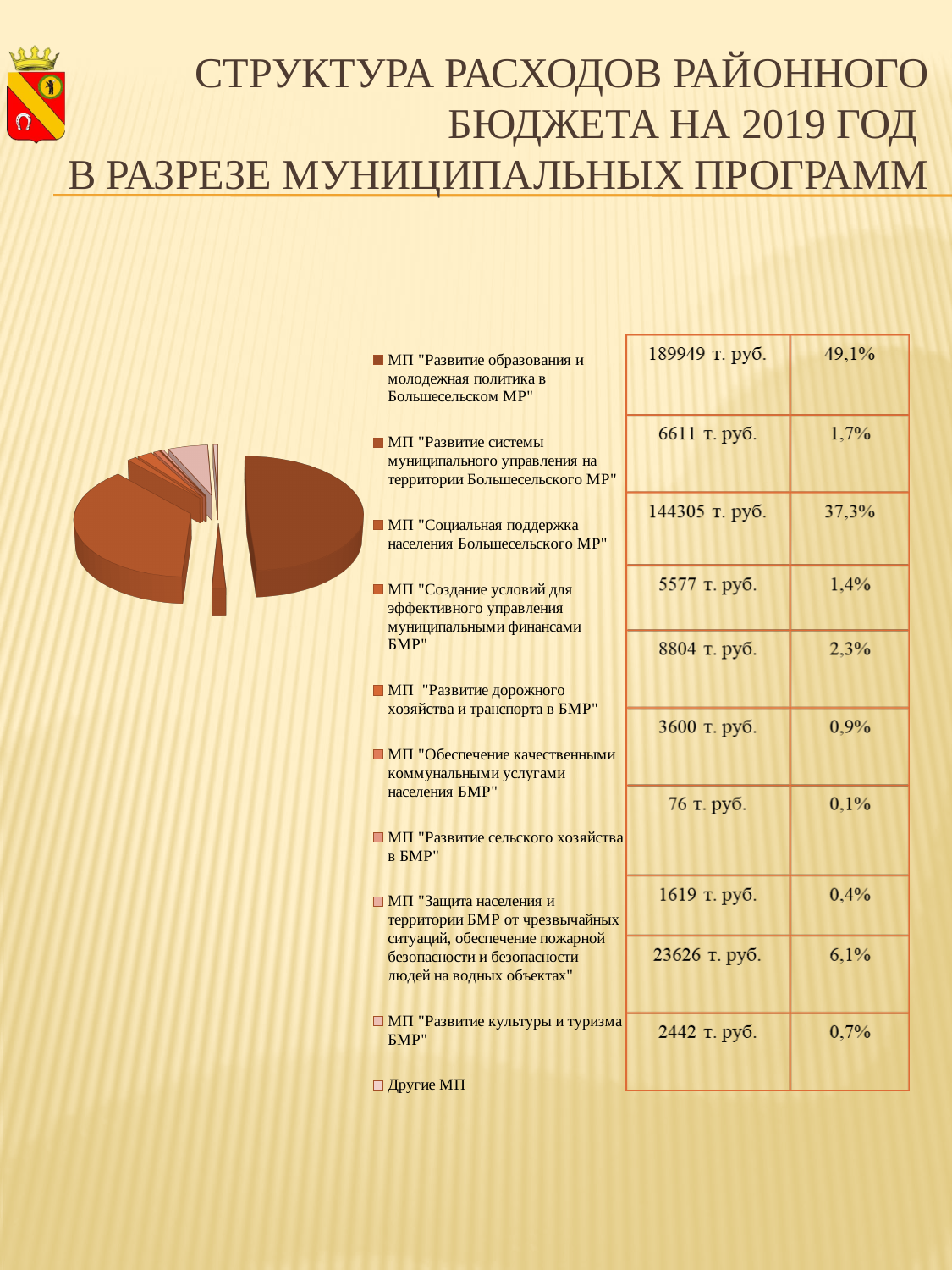
What kind of chart is shown on the slide? Pie chart What is the title of the slide containing the pie chart? СТРУКТУРА РАСХОДОВ РАЙОННОГО БЮДЖЕТА НА 2019 ГОД В РАЗРЕЗЕ МУНИЦИПАЛЬНЫХ ПРОГРАММ What share of the budget does МП "Социальная поддержка населения Большесельского МР" account for? 37,3% What is the amount shown for МП "Развитие дорожного хозяйства и транспорта в БМР"? 8804 т. руб. What is the amount shown for МП "Развитие культуры и туризма БМР"? 23626 т. руб. Which municipal programme has the smallest share of the pie chart? МП "Развитие сельского хозяйства в БМР" What share of the budget does МП "Развитие образования и молодежная политика в Большесельском МР" account for? 49,1% Which municipal programme has the largest slice of the pie chart? МП "Развитие образования и молодежная политика в Большесельском МР" How many categories does the legend of the pie chart list? 10 By how many percentage points does the share of МП "Развитие образования и молодежная политика в Большесельском МР" exceed that of МП "Социальная поддержка населения Большесельского МР"? 11,8 Which is larger: the share for МП "Развитие системы муниципального управления на территории Большесельского МР" or for МП "Создание условий для эффективного управления муниципальными финансами БМР"? МП "Развитие системы муниципального управления на территории Большесельского МР" What percentage is shown for "Другие МП"? 0,7%